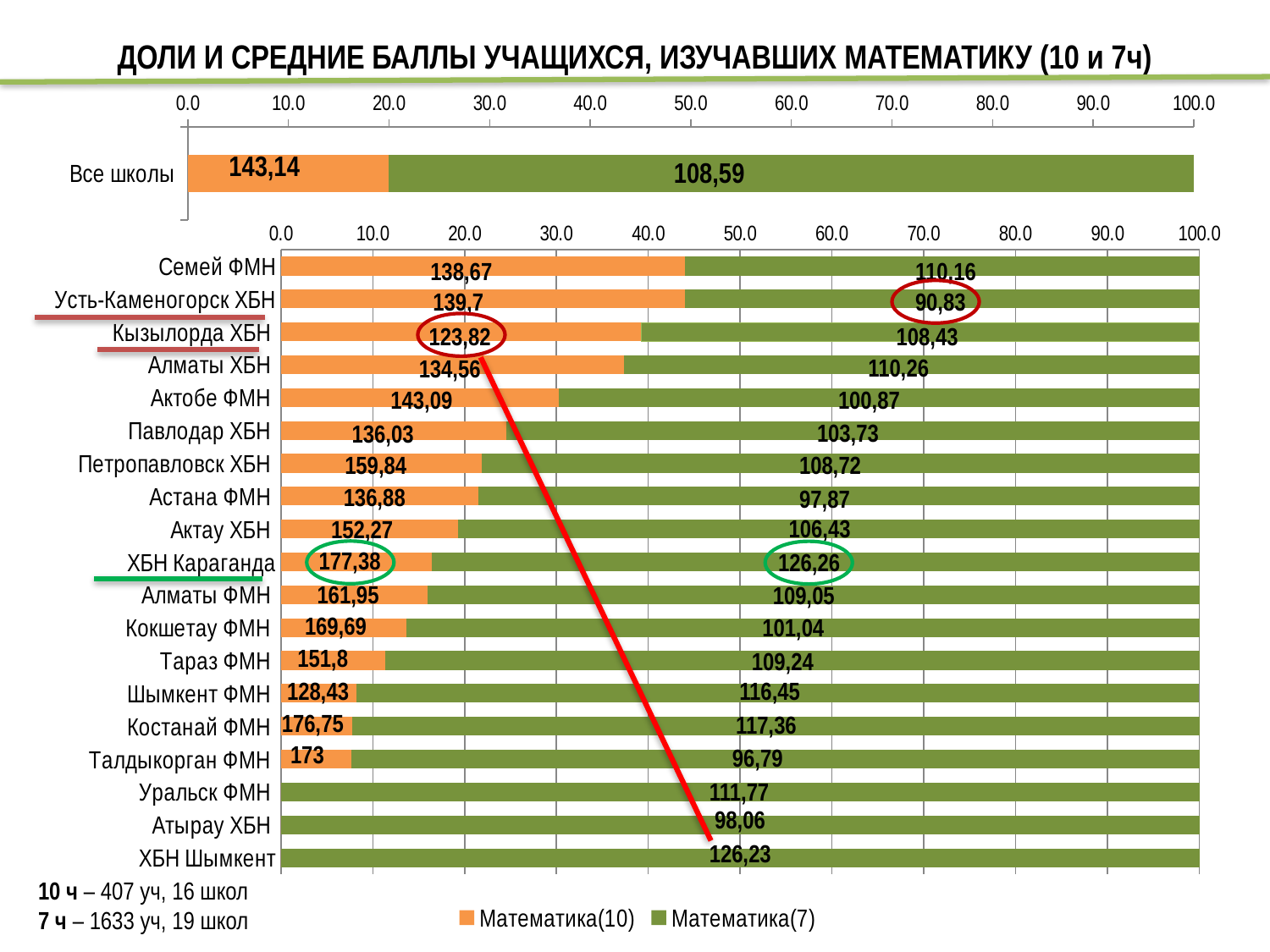
In the top chart, what is the value labelled on the Математика(7) bar for Все школы? 108,59 In the bottom chart, what value is labelled on the Математика(10) bar for Петропавловск ХБН? 159,84 In the top chart, what is the value labelled on the Математика(10) bar for Все школы? 143,14 In the bottom chart, which is larger: the Математика(10) label for Петропавловск ХБН or for Астана ФМН? Петропавловск ХБН In the bottom chart, what value is labelled on the Математика(7) bar for Усть-Каменогорск ХБН? 90,83 In the bottom chart, which school has the lowest labelled Математика(7) value? Усть-Каменогорск ХБН How many series does the legend list? 2 How many schools are listed on the vertical axis of the bottom chart? 19 In the top chart, what is the difference between the two labelled values for Все школы (143,14 and 108,59)? 34,55 In the bottom chart, what is the difference between the Математика(10) label (138,67) and the Математика(7) label (110,16) for Семей ФМН? 28,51 In the bottom chart, is the share of the Математика(10) bar for Семей ФМН greater or less than 40? greater In the bottom chart, which school has the highest labelled Математика(10) value? ХБН Караганда